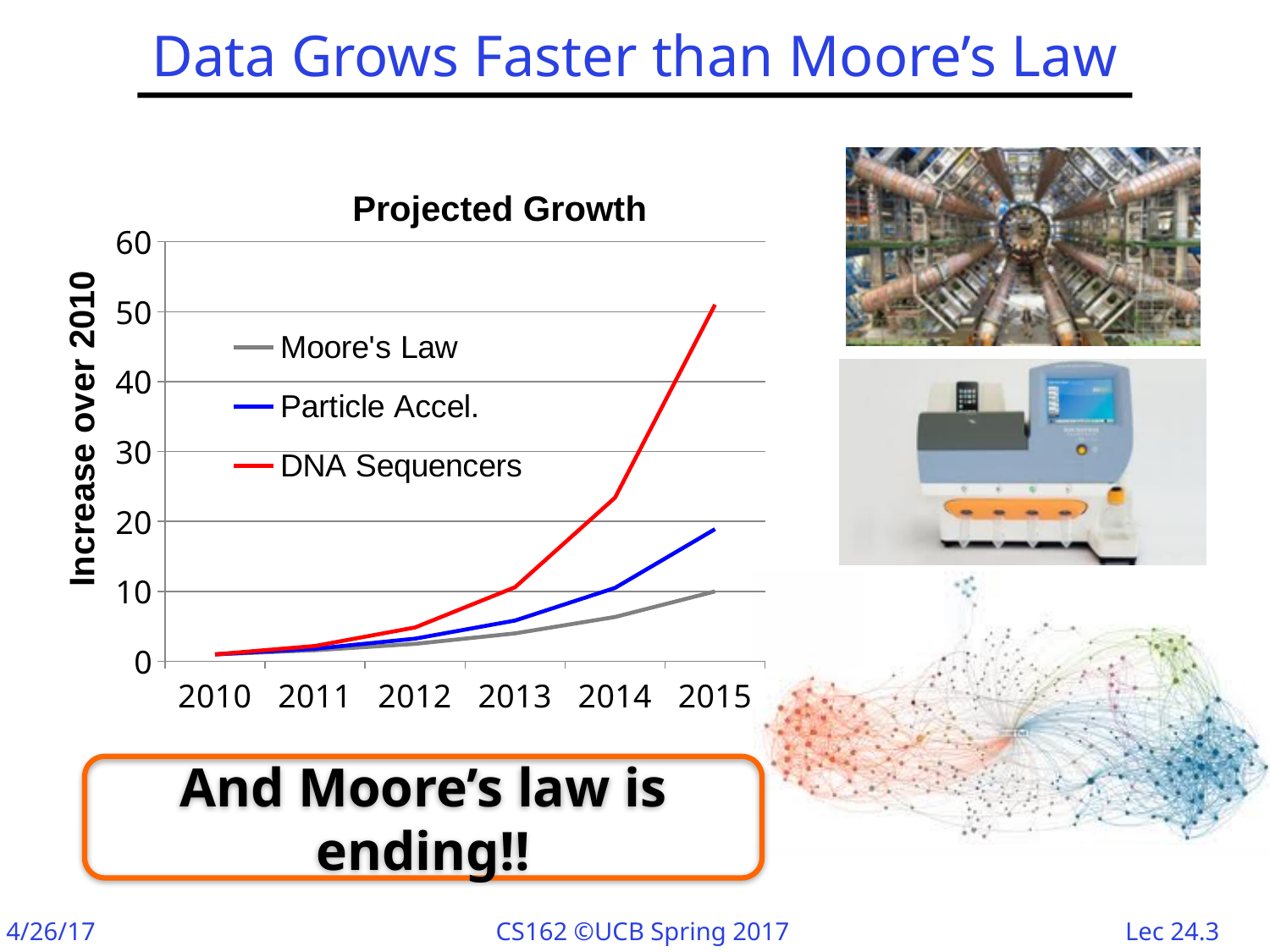
What kind of chart is shown under the title "Projected Growth"? line chart Is the value for DNA Sequencers in 2014 greater or less than 20? greater Is the value for Particle Accel. in 2013 greater or less than 10? less What is the label on the y axis of the "Projected Growth" chart? Increase over 2010 How many years are shown on the x axis of the "Projected Growth" chart? 6 Do the values for DNA Sequencers rise or fall from 2010 to 2015? rise How many series does the legend of the "Projected Growth" chart list? 3 Which series has the lowest value in 2015 in the "Projected Growth" chart? Moore's Law In 2014, which is larger: Particle Accel. or Moore's Law? Particle Accel. Which series has the highest value in 2015 in the "Projected Growth" chart? DNA Sequencers Is the value for DNA Sequencers in 2015 greater or less than 40? greater